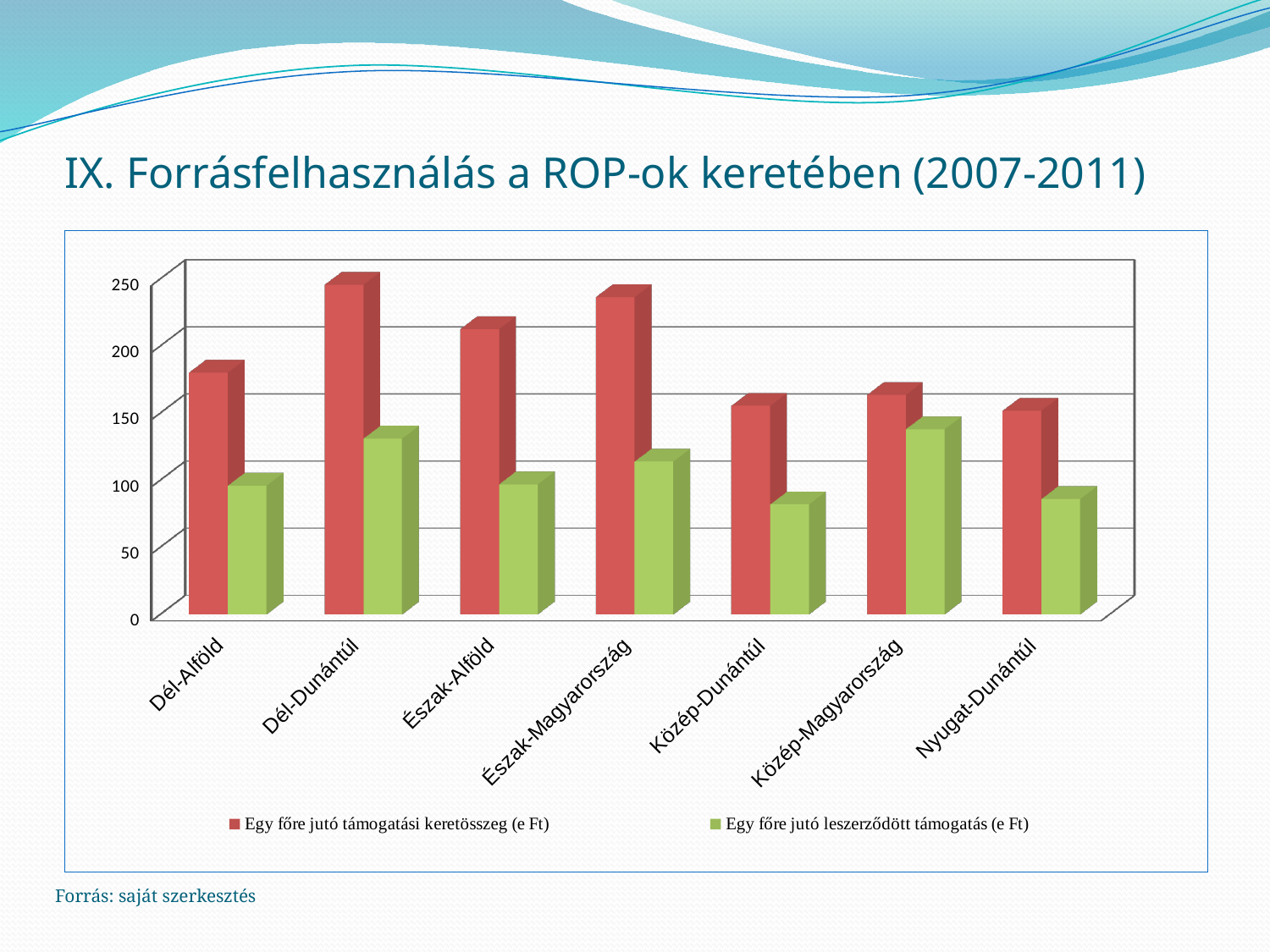
Is the value for 'Egy főre jutó támogatási keretösszeg (e Ft)' in Dél-Alföld greater or less than 200? less What kind of chart is shown on the slide? bar chart How many regions (categories) are shown on the x axis of the chart? 7 How many series does the chart's legend list? 2 Is the value for 'Egy főre jutó támogatási keretösszeg (e Ft)' in Észak-Magyarország greater or less than 200? greater Which is larger: the 'Egy főre jutó támogatási keretösszeg (e Ft)' value for Dél-Dunántúl or for Közép-Dunántúl? Dél-Dunántúl Which is larger: the 'Egy főre jutó leszerződött támogatás (e Ft)' value for Közép-Magyarország or for Dél-Alföld? Közép-Magyarország Which region has the highest value for 'Egy főre jutó támogatási keretösszeg (e Ft)'? Dél-Dunántúl Is the value for 'Egy főre jutó támogatási keretösszeg (e Ft)' in Dél-Dunántúl greater or less than 200? greater Which colour represents the series 'Egy főre jutó leszerződött támogatás (e Ft)' in the chart? green